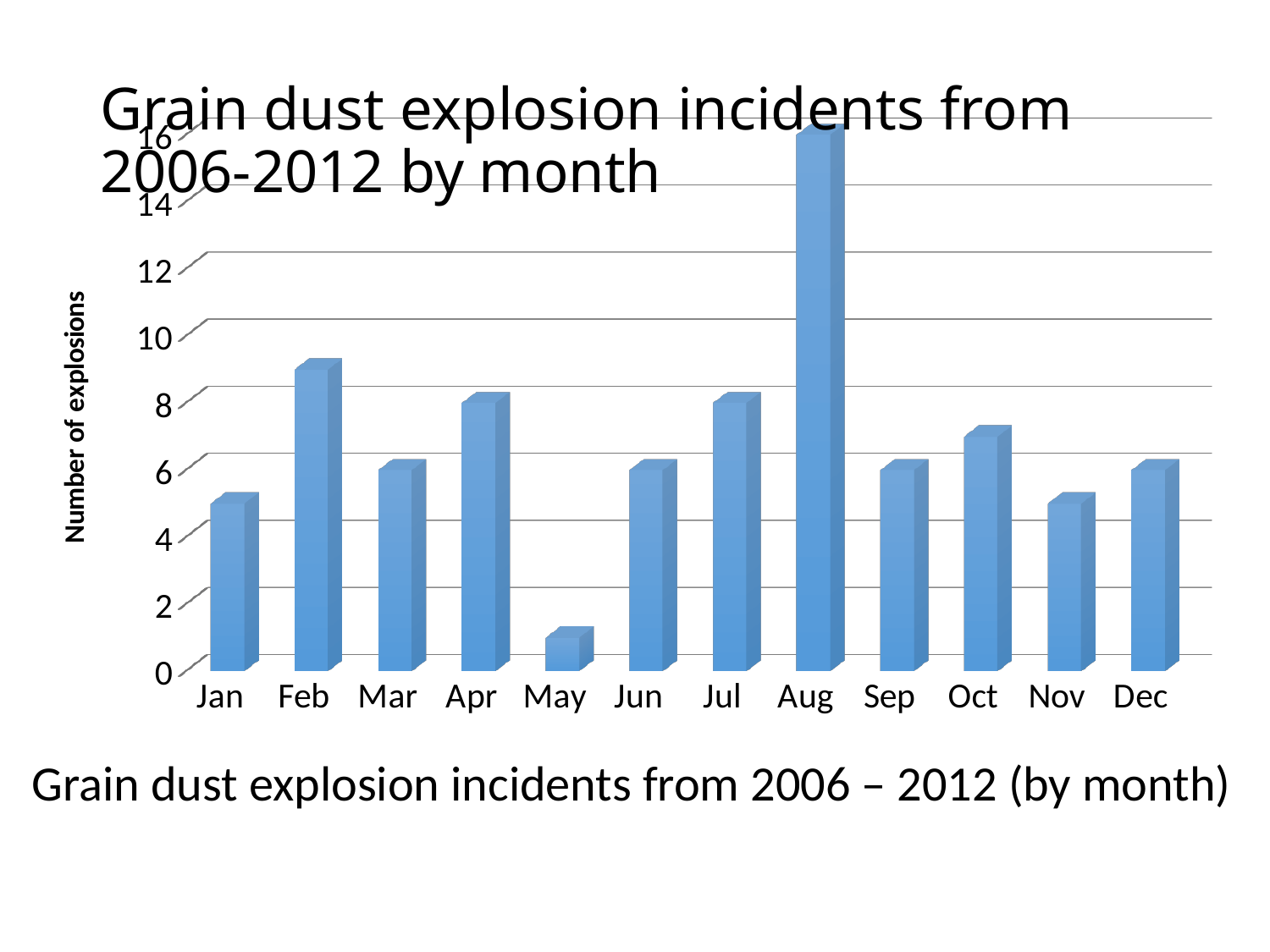
Which month has the lowest number of explosions? May What is the label on the vertical axis of the chart? Number of explosions Is the value for May greater or less than 2? less Is the value for Apr greater or less than 6? greater Which month has more explosions, Jul or Nov? Jul Is the value for Jan greater or less than 6? less How many months are shown on the x axis of the chart? 12 What kind of chart is shown on the slide? bar chart Which month has the highest number of explosions? Aug Which month has more explosions, Feb or Mar? Feb